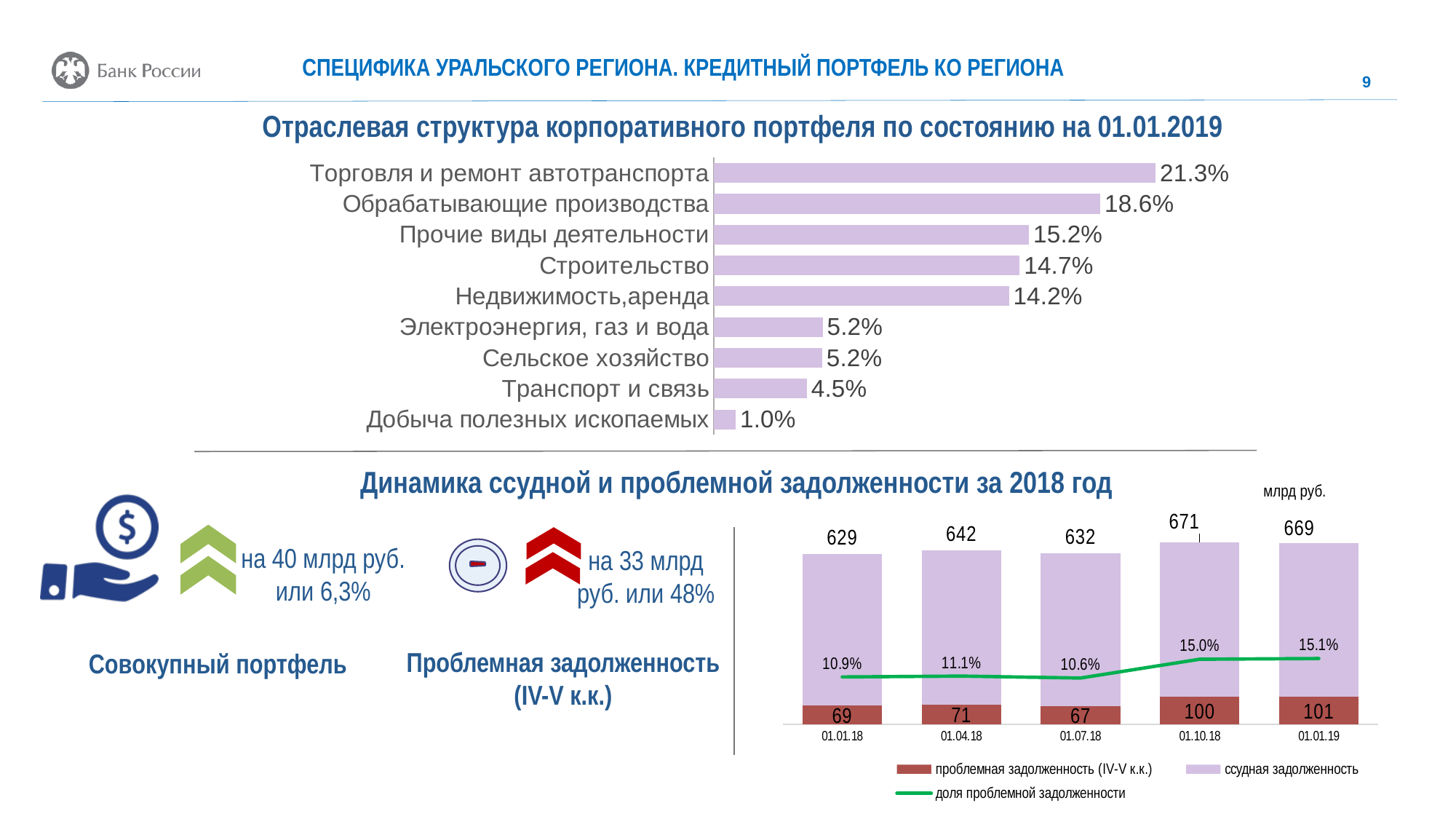
In the bottom chart 'Динамика ссудной и проблемной задолженности за 2018 год', what is the value of проблемная задолженность (IV-V к.к.) for 01.10.18? 100 How many series does the legend of the bottom chart 'Динамика ссудной и проблемной задолженности за 2018 год' list? 3 What type of chart is the top chart 'Отраслевая структура корпоративного портфеля'? Bar chart In the top chart 'Отраслевая структура корпоративного портфеля', what is the difference between Торговля и ремонт автотранспорта and Обрабатывающие производства? 2.7% How many categories are shown in the top chart 'Отраслевая структура корпоративного портфеля'? 9 In the top chart 'Отраслевая структура корпоративного портфеля', which is larger: Прочие виды деятельности or Недвижимость,аренда? Прочие виды деятельности In the top chart 'Отраслевая структура корпоративного портфеля', which category has the highest share? Торговля и ремонт автотранспорта In the bottom chart 'Динамика ссудной и проблемной задолженности за 2018 год', what is the difference in проблемная задолженность (IV-V к.к.) between 01.01.19 and 01.01.18? 32 In the top chart 'Отраслевая структура корпоративного портфеля по состоянию на 01.01.2019', what is the value for Строительство? 14.7% In the bottom chart 'Динамика ссудной и проблемной задолженности за 2018 год', what is the доля проблемной задолженности for 01.07.18? 10.6% In the top chart 'Отраслевая структура корпоративного портфеля', which category has the lowest share? Добыча полезных ископаемых In the bottom chart 'Динамика ссудной и проблемной задолженности за 2018 год', what value is labelled above the bar for 01.04.18? 642